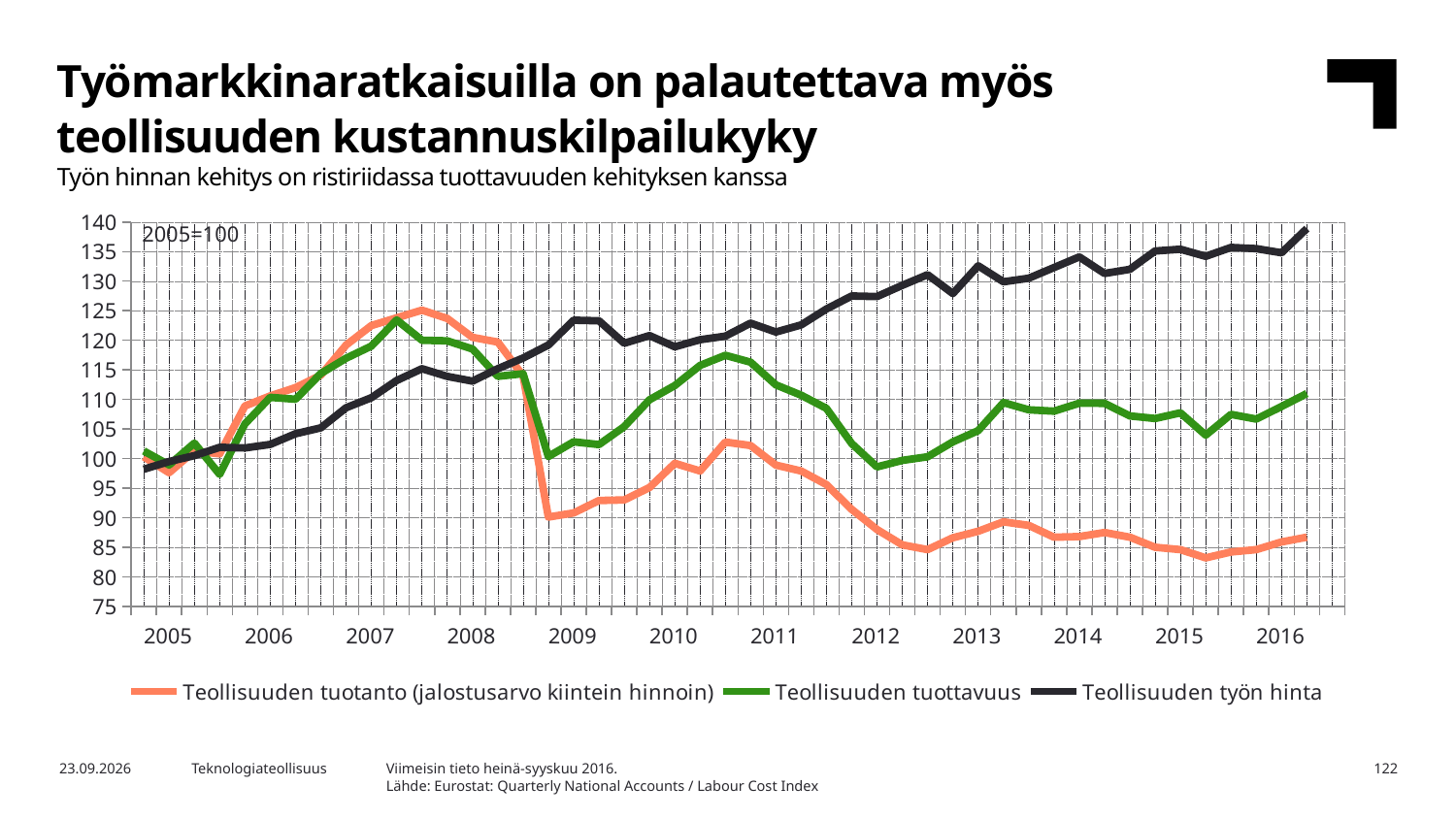
Is the peak value for Teollisuuden tuotanto in 2007 greater or less than 120? greater Is the value for Teollisuuden tuottavuus at the end of 2016 greater or less than 105? greater Does the Teollisuuden tuotanto line rise or fall between 2008 and 2009? fall In 2016, which series is higher: Teollisuuden työn hinta or Teollisuuden tuotanto? Teollisuuden työn hinta How many year labels are shown on the x axis? 12 How many series does the legend list? 3 Does the Teollisuuden työn hinta line rise or fall overall from 2005 to 2016? rise Is the value for Teollisuuden tuotanto in 2016 greater or less than 90? less What colour is the line for Teollisuuden tuottavuus? green What base year and index value is noted in the top-left corner of the chart? 2005=100 What kind of chart is shown on the slide? line chart